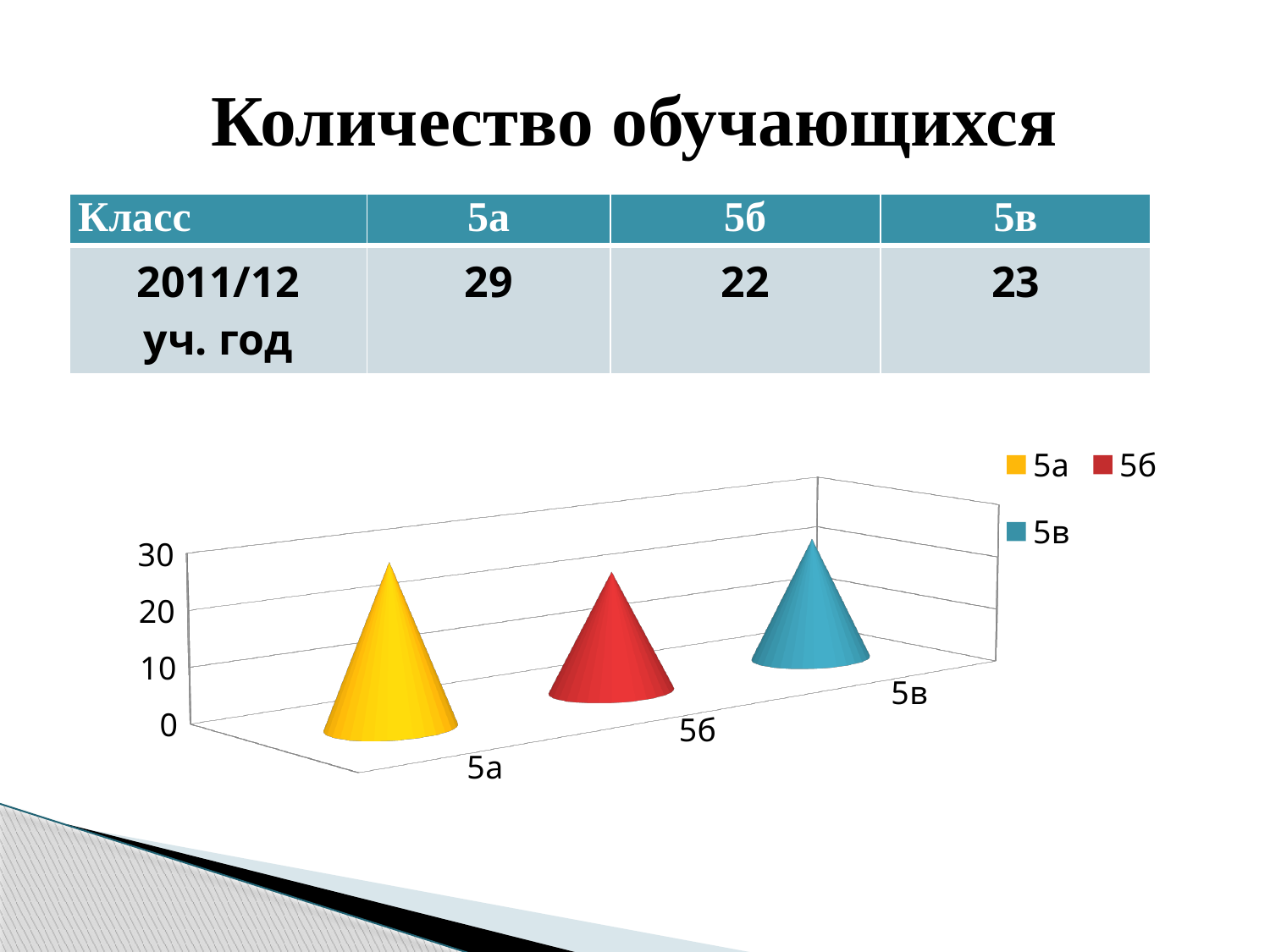
What is the value for class 5а? 29 What is the difference between the values for 5а and 5б? 7 Is the value for 5б greater or less than 30? less What is the value for class 5б? 22 Which class has the highest number of students? 5а What kind of chart is shown on the slide? bar chart Which class has the lowest number of students? 5б How many classes are shown on the chart? 3 Is the value for 5в greater or less than 10? greater Which is larger, the value for 5а or the value for 5в? 5а How many entries does the chart legend list? 3 What is the value for class 5в? 23